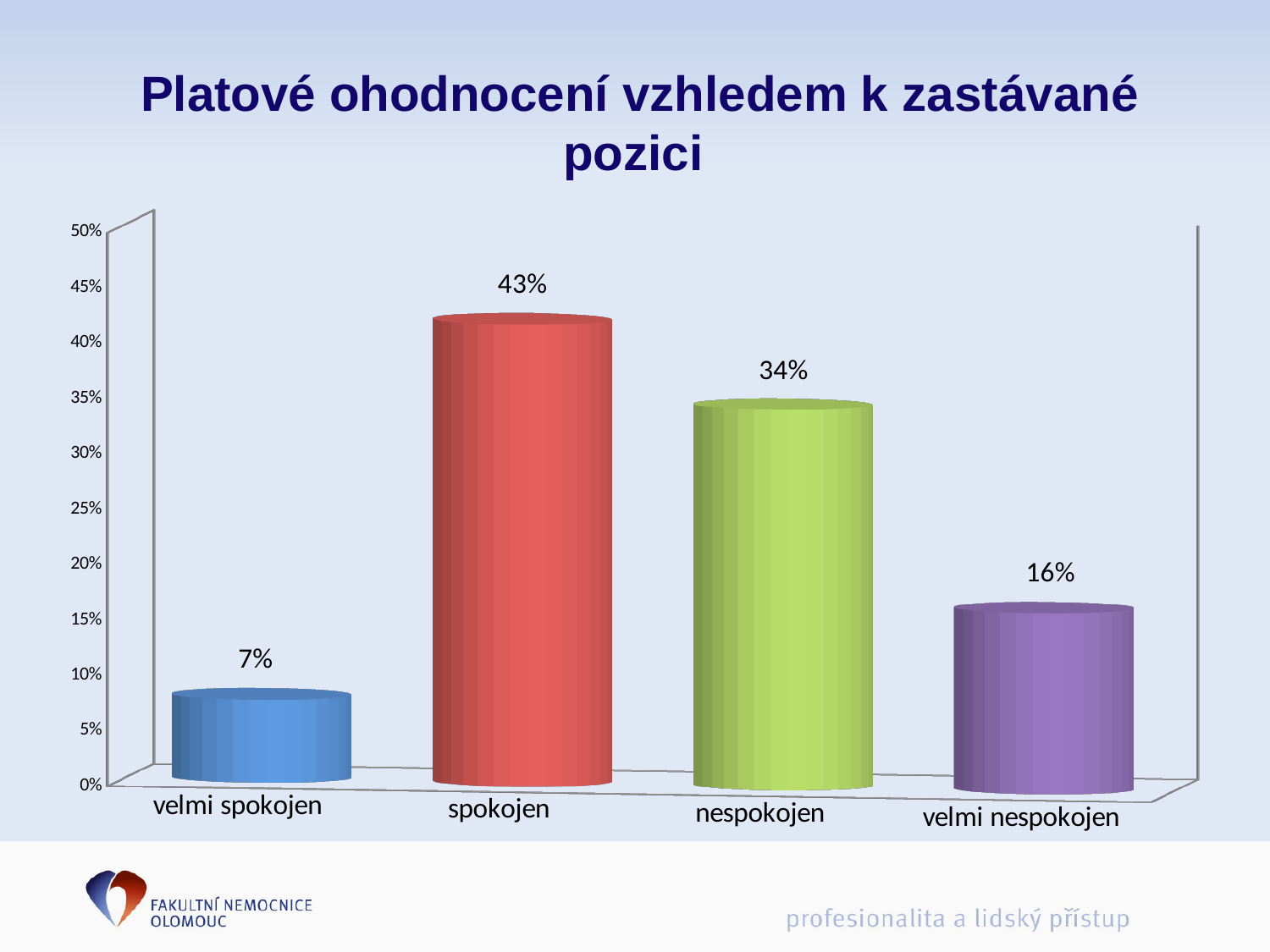
Which is larger, the value for "velmi nespokojen" or the value for "velmi spokojen"? velmi nespokojen What is the value for "velmi spokojen"? 7% What is the value for "velmi nespokojen"? 16% Which category has the highest value? spokojen Which category has the lowest value? velmi spokojen What is the title of the chart on the slide? Platové ohodnocení vzhledem k zastávané pozici What is the difference between the values for "spokojen" and "nespokojen"? 9% What is the value for "nespokojen"? 34% What is the value for "spokojen"? 43% Is the value for "nespokojen" greater or less than 30%? greater What kind of chart is shown on the slide? bar chart How many categories are shown on the x axis? 4